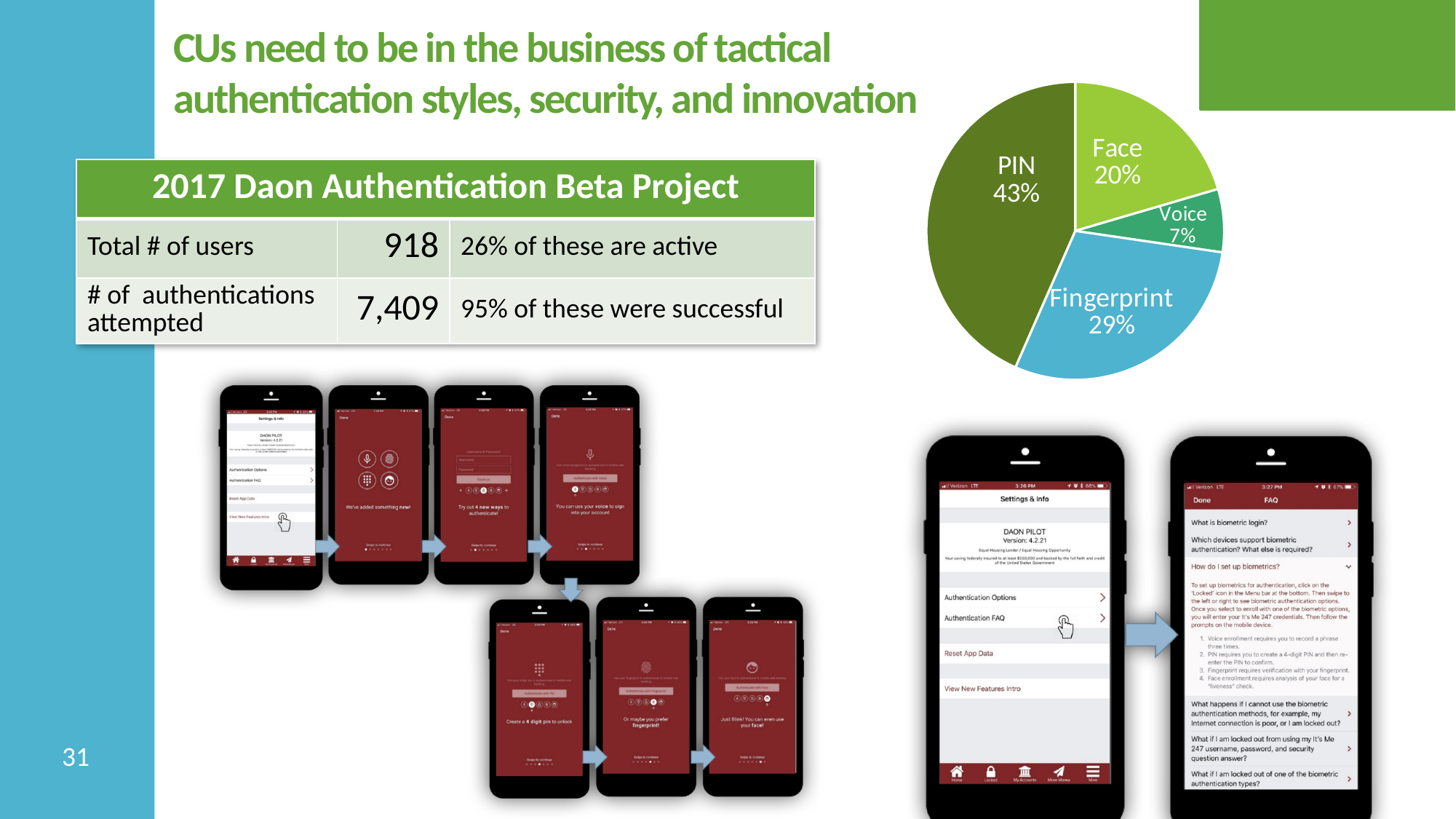
What is the combined share of the Face and Voice slices in the pie chart? 27% Which authentication method has the largest slice in the pie chart? PIN What kind of chart is shown on the slide? pie chart What share of the pie chart does Fingerprint represent? 29% What share of the pie chart does PIN represent? 43% What is the difference in percentage points between the PIN slice and the Fingerprint slice? 14 Which authentication method has the smallest slice in the pie chart? Voice What share of the pie chart does Face represent? 20% Which slice is larger in the pie chart, Face or Voice? Face What share of the pie chart does Voice represent? 7% How many slices does the pie chart have? 4 What colour is the Fingerprint slice in the pie chart? blue